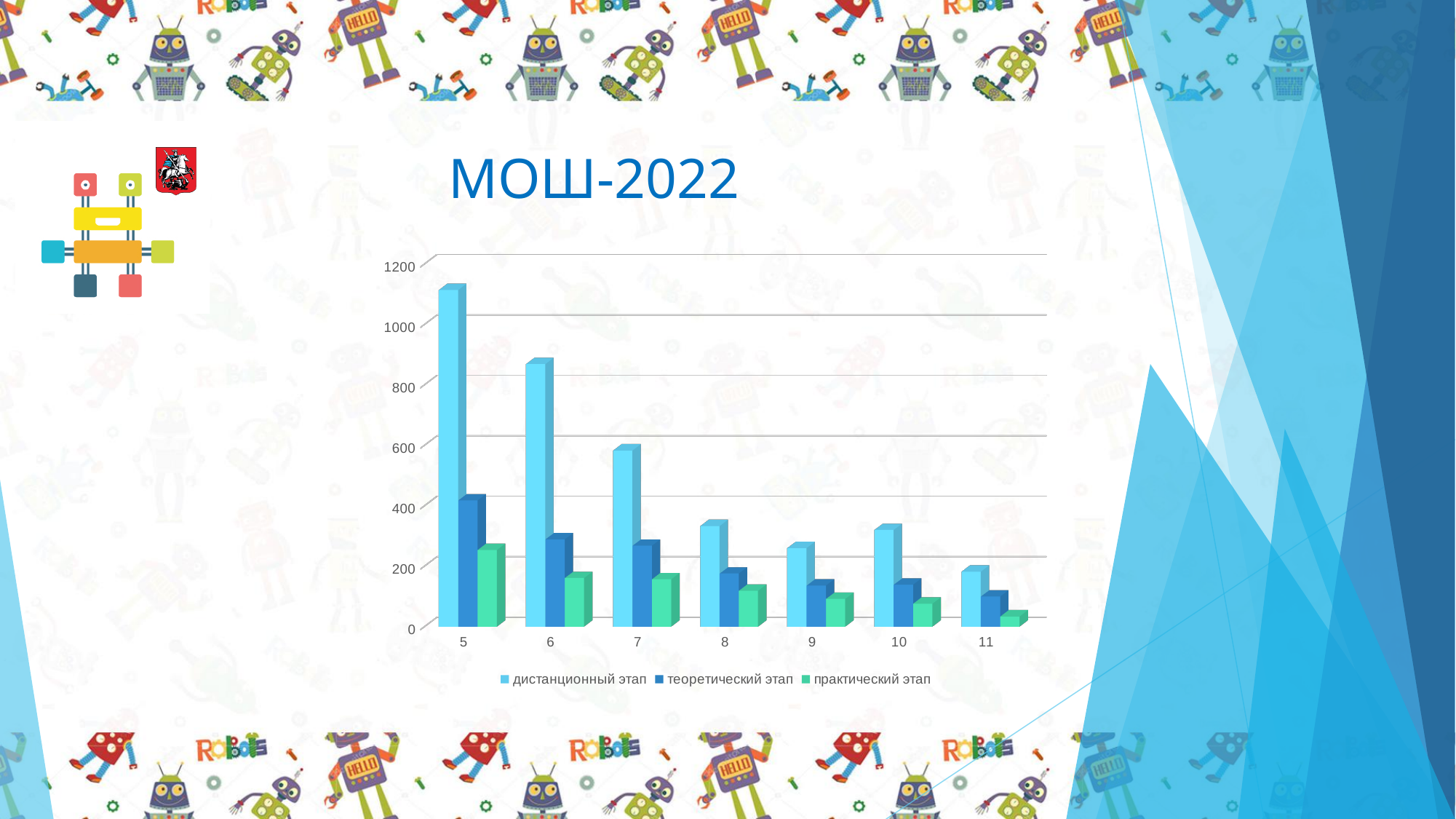
What is the title of the slide with the chart? МОШ-2022 How many categories are shown on the x axis? 7 How many series does the legend list? 3 Which is larger in category 5: теоретический этап or практический этап? теоретический этап Which category has the highest value for дистанционный этап? 5 Is the value for практический этап in category 5 greater or less than 400? less Which category has the lowest value for дистанционный этап? 11 Is the value for дистанционный этап in category 11 greater or less than 200? less Is the value for дистанционный этап in category 5 greater or less than 1000? greater Which series is shown in green in the legend? практический этап What kind of chart is shown on the slide? bar chart